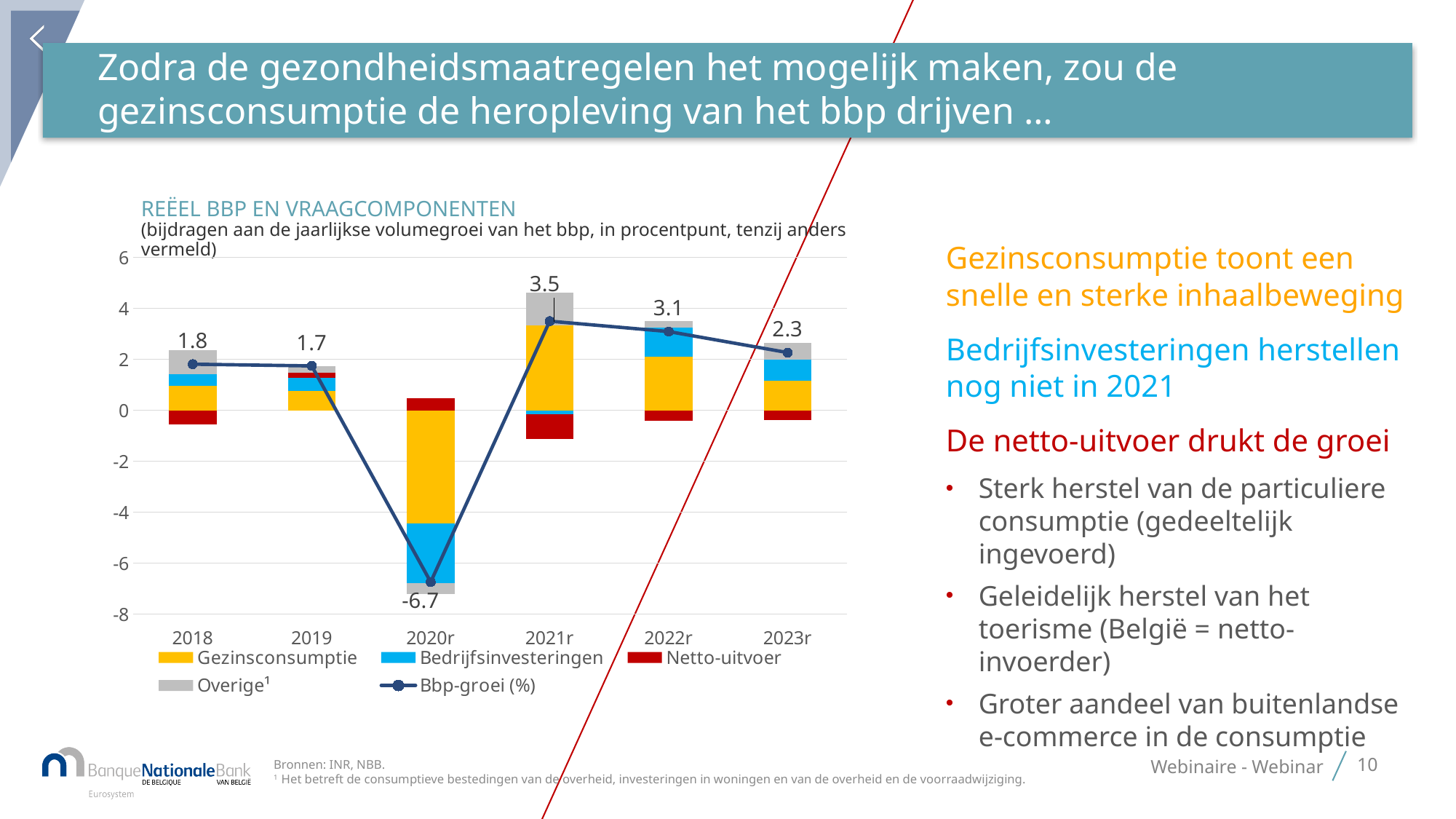
How many years are shown on the x axis of the chart? 6 How many series does the chart legend list? 5 Which is larger, the Bbp-groei (%) value for 2022r or for 2023r? 2022r Does the Bbp-groei (%) line rise or fall from 2021r to 2023r? Fall Is the Gezinsconsumptie contribution for 2021r greater or less than 2? greater What kind of chart is shown on the slide? Stacked bar chart with a line What is the Bbp-groei (%) value for 2020r? -6.7 Which year has the highest Bbp-groei (%) value? 2021r What is the Bbp-groei (%) value for 2021r? 3.5 What is the Bbp-groei (%) value for 2018? 1.8 What is the difference between the Bbp-groei (%) values for 2021r and 2018? 1.7 Which year has the lowest Bbp-groei (%) value? 2020r